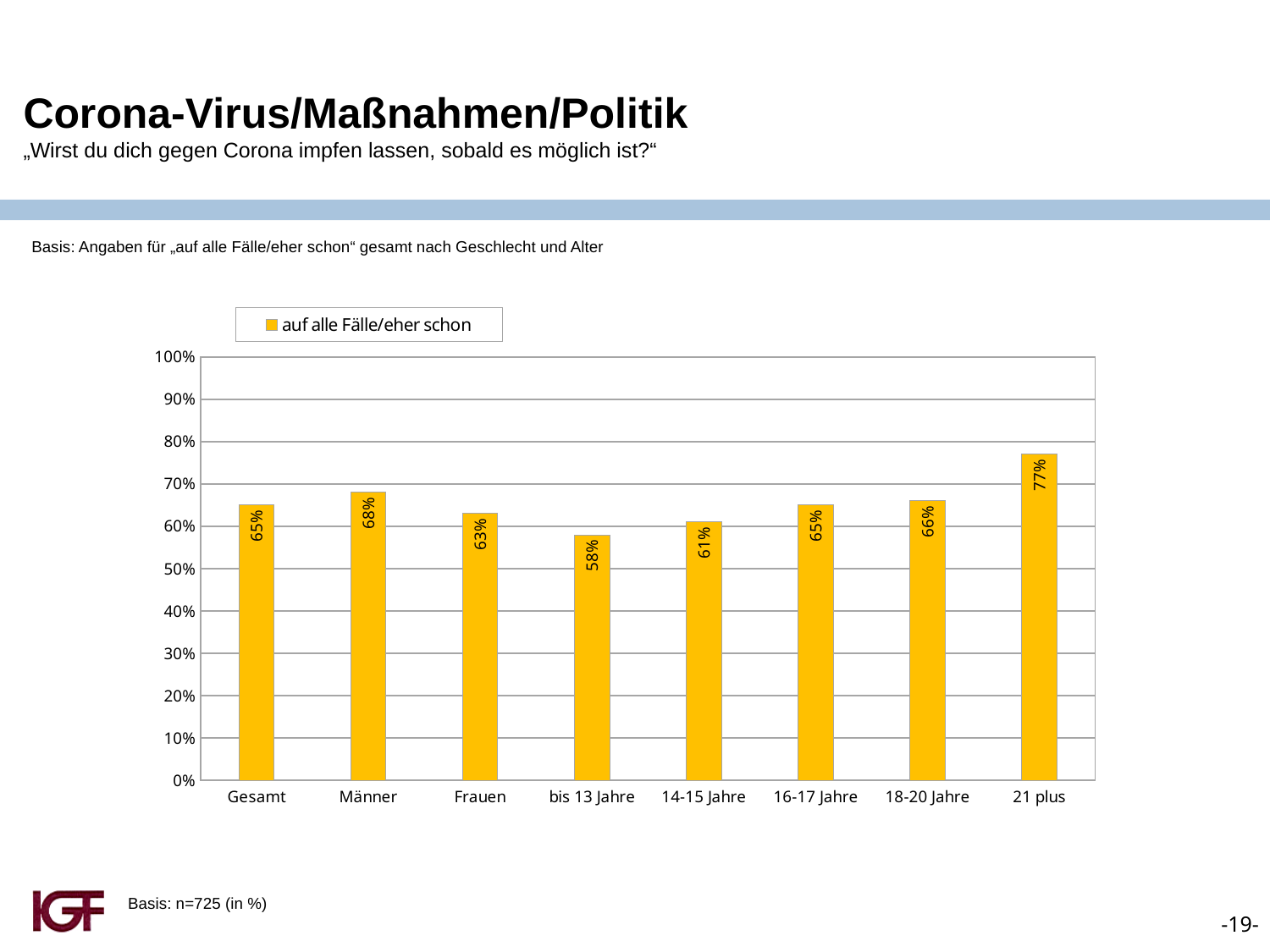
Is the value for 16-17 Jahre greater or less than 50%? greater Which is larger, the value for 18-20 Jahre or the value for 14-15 Jahre? 18-20 Jahre What is the difference between the values for Männer and Frauen? 5% Which category has the highest value? 21 plus What kind of chart is shown? bar chart Which category has the lowest value? bis 13 Jahre What series name does the legend show? auf alle Fälle/eher schon What is the value for Gesamt? 65% How many categories are shown on the x axis? 8 What is the value for 21 plus? 77% What is the value for bis 13 Jahre? 58% What is the value for Männer? 68%